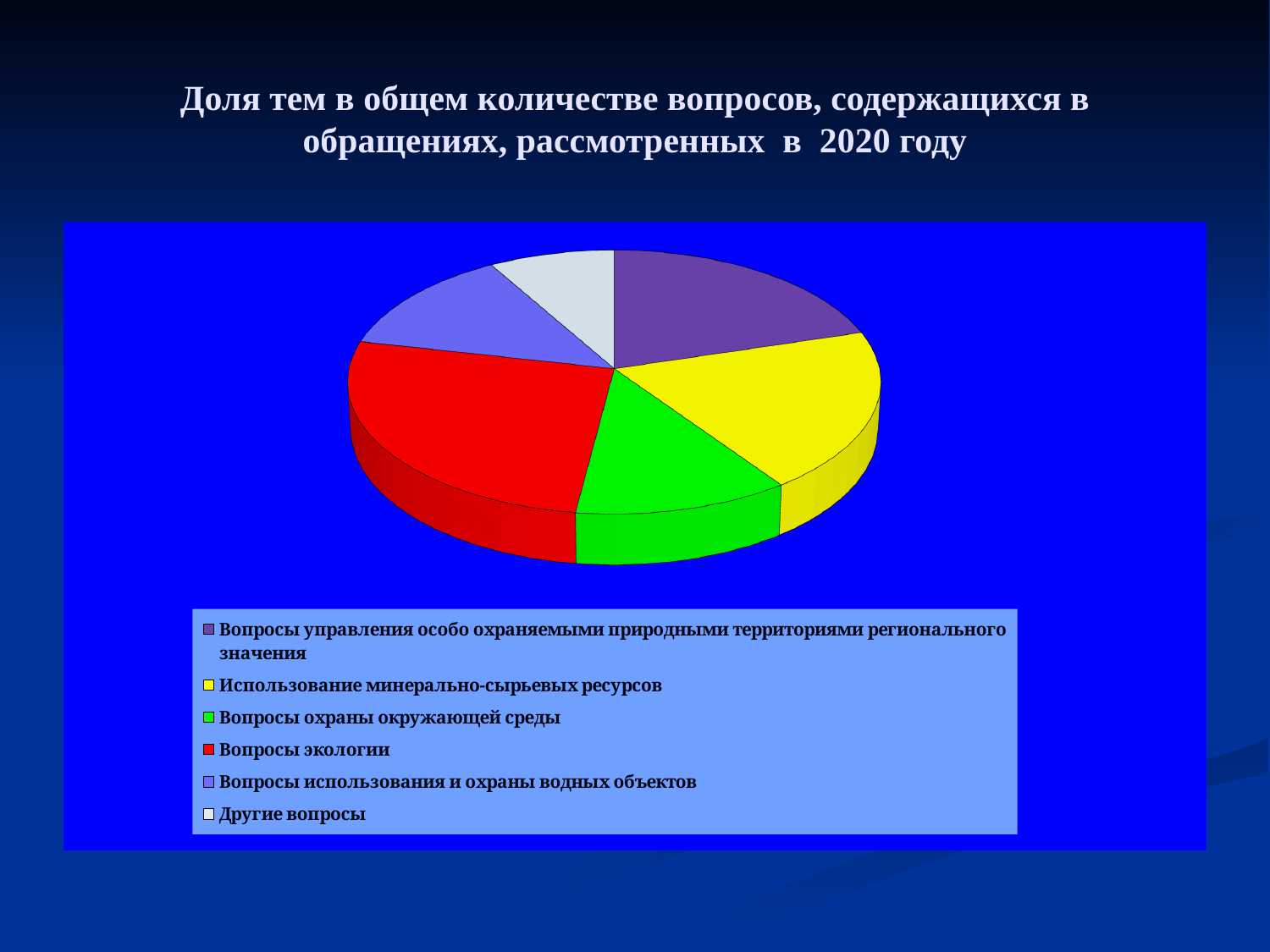
How many entries does the legend of the pie chart list? 6 What kind of chart is shown on the slide? pie chart Which category has the largest slice in the pie chart? Вопросы экологии Which slice is larger: Вопросы экологии or Вопросы охраны окружающей среды? Вопросы экологии What colour represents Вопросы экологии in the pie chart? red Which slice is larger: Вопросы управления особо охраняемыми природными территориями регионального значения or Другие вопросы? Вопросы управления особо охраняемыми природными территориями регионального значения What is the title of the chart on the slide? Доля тем в общем количестве вопросов, содержащихся в обращениях, рассмотренных в 2020 году Which slice is larger: Вопросы экологии or Использование минерально-сырьевых ресурсов? Вопросы экологии How many categories (slices) does the pie chart have? 6